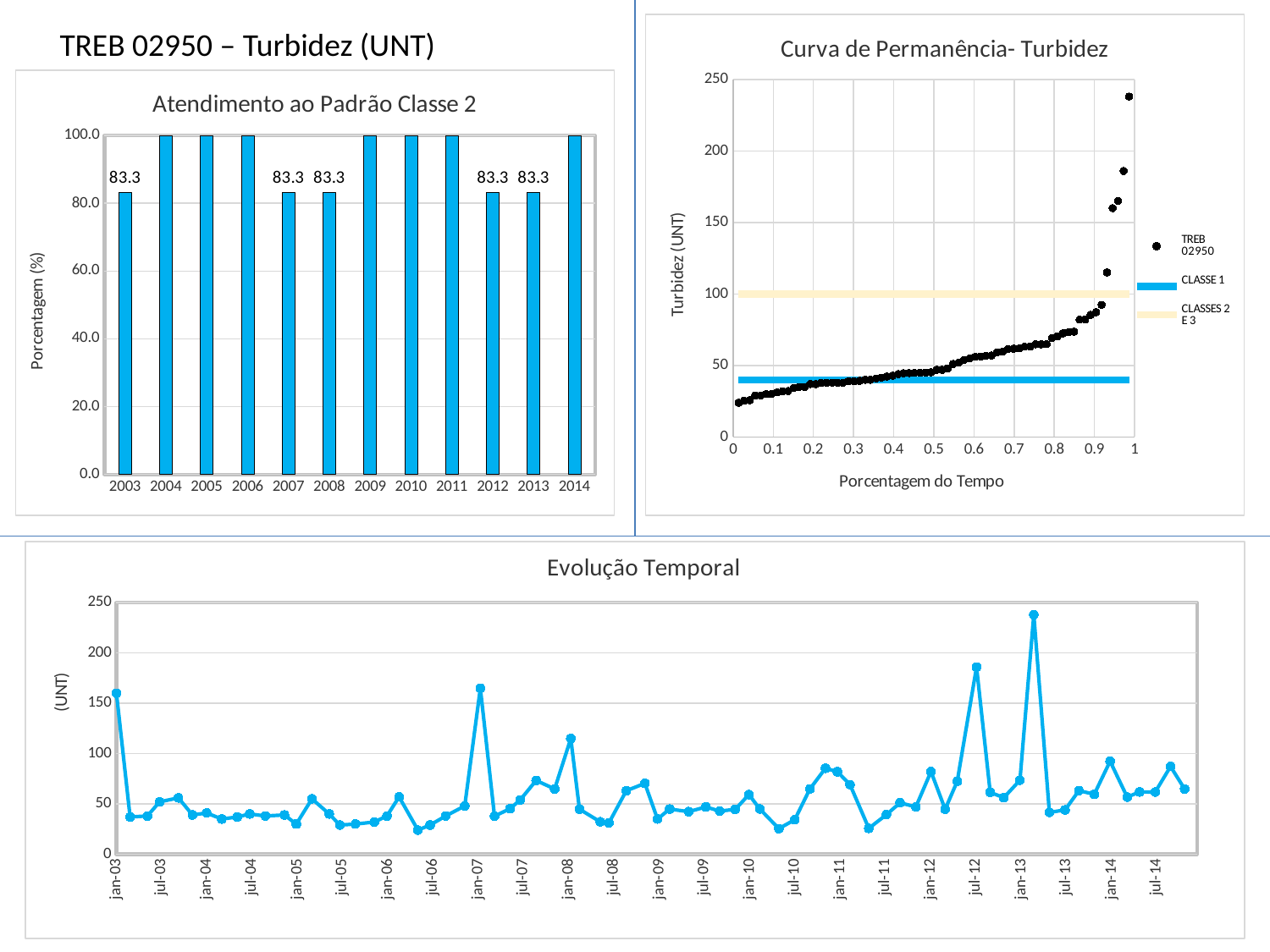
In the 'Atendimento ao Padrão Classe 2' chart, what is the difference between the value for 2005 and the value for 2007? 16.7 In the 'Atendimento ao Padrão Classe 2' chart, what is the value for 2003? 83.3 In the 'Curva de Permanência- Turbidez' chart, do the TREB 02950 values rise or fall as Porcentagem do Tempo increases? rise In the 'Atendimento ao Padrão Classe 2' chart, how many years are shown on the x axis? 12 In the 'Atendimento ao Padrão Classe 2' chart, what is the value for 2004? 100.0 How many series does the legend of the 'Curva de Permanência- Turbidez' chart list? 3 What kind of chart is 'Atendimento ao Padrão Classe 2'? bar chart In the 'Atendimento ao Padrão Classe 2' chart, what is the value for 2012? 83.3 In the 'Evolução Temporal' chart, is the value at jan-04 greater or less than 100? less In the 'Curva de Permanência- Turbidez' chart, what is the label of the y axis? Turbidez (UNT) In the 'Evolução Temporal' chart, is the highest peak (near jan-13) greater or less than 200? greater In the 'Atendimento ao Padrão Classe 2' chart, which is larger, the value for 2009 or the value for 2013? 2009